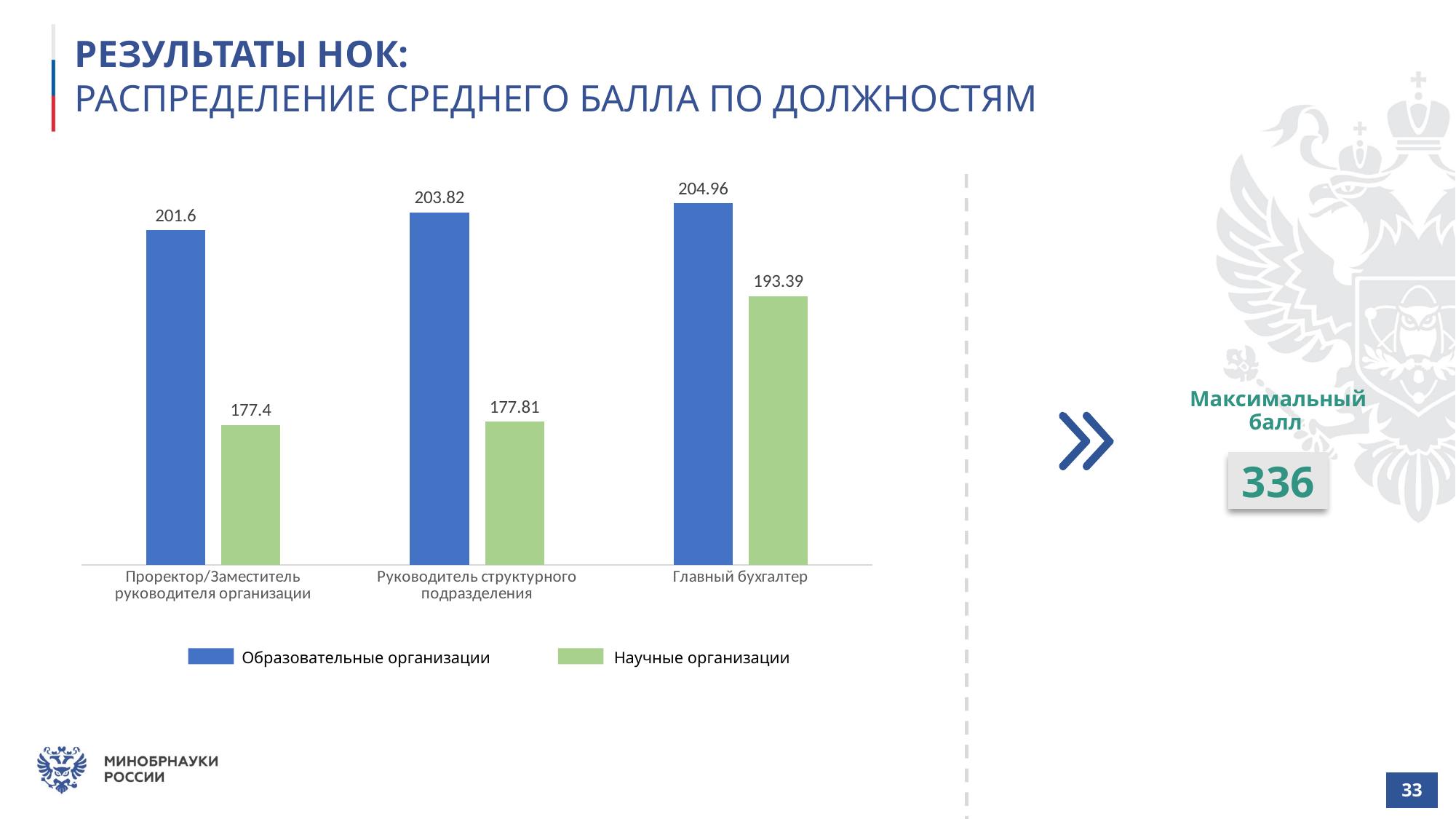
What is the difference between Образовательные организации and Научные организации for Проректор/Заместитель руководителя организации? 24.2 Which category has the highest value for Научные организации? Главный бухгалтер How many series does the legend list? 2 What kind of chart is shown on the slide? Bar chart How many categories are shown on the x axis of the chart? 3 What is the value for Образовательные организации for Главный бухгалтер? 204.96 What is the value for Научные организации for Руководитель структурного подразделения? 177.81 What is the difference between Образовательные организации and Научные организации for Главный бухгалтер? 11.57 Which is larger for Руководитель структурного подразделения: Образовательные организации or Научные организации? Образовательные организации What is the value for Образовательные организации for Руководитель структурного подразделения? 203.82 What is the value for Научные организации for Проректор/Заместитель руководителя организации? 177.4 Which category has the lowest value for Образовательные организации? Проректор/Заместитель руководителя организации